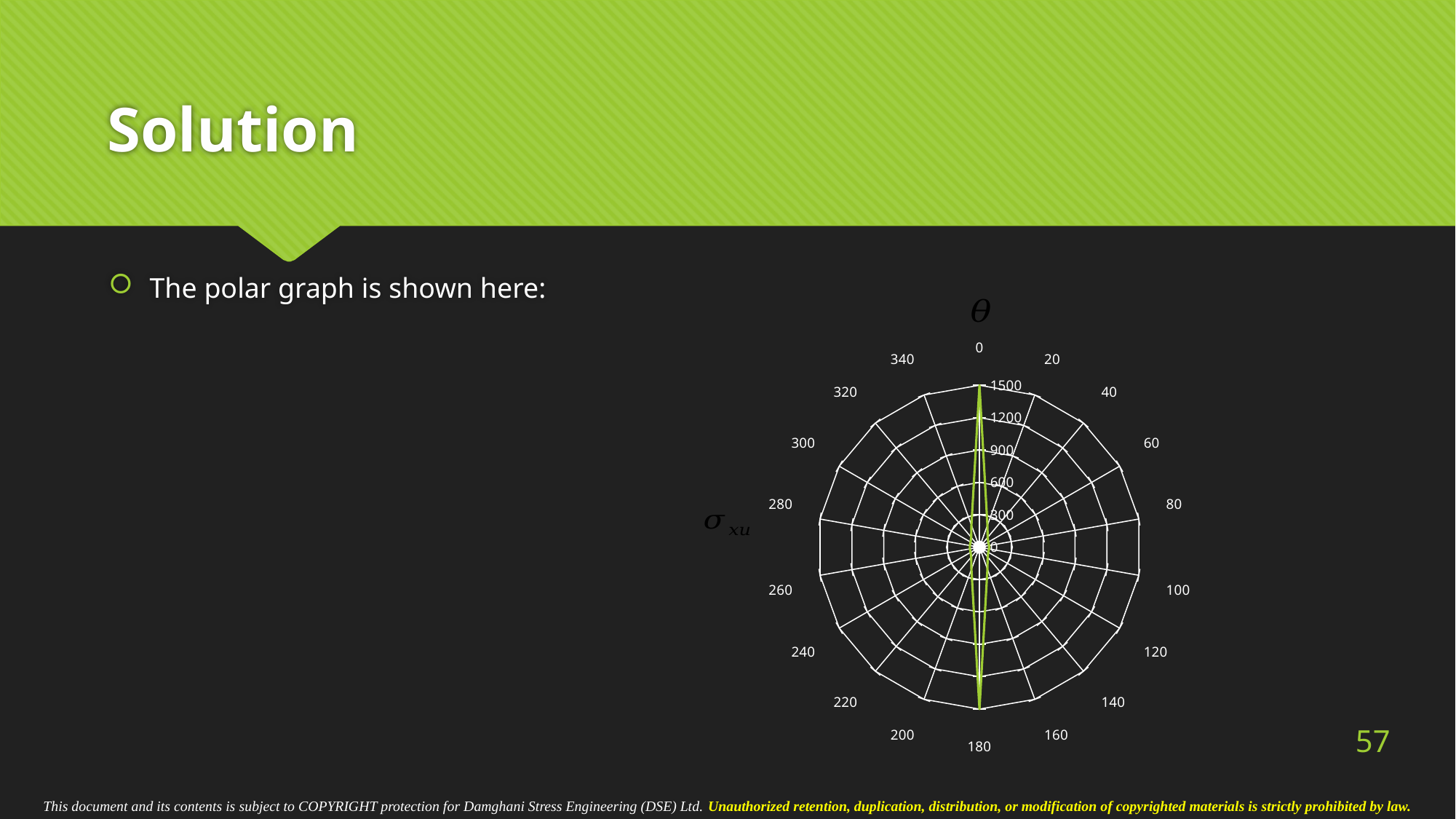
What kind of chart is shown on the slide? polar (radar) chart What is the largest value labelled on the radial axis of the polar chart? 1500 How many angle labels are shown around the polar chart? 18 Is the plotted value at angle 180 greater or less than 1200? greater What is the spacing between consecutive radial axis labels on the polar chart? 300 Is the plotted value at angle 0 greater or less than 1200? greater